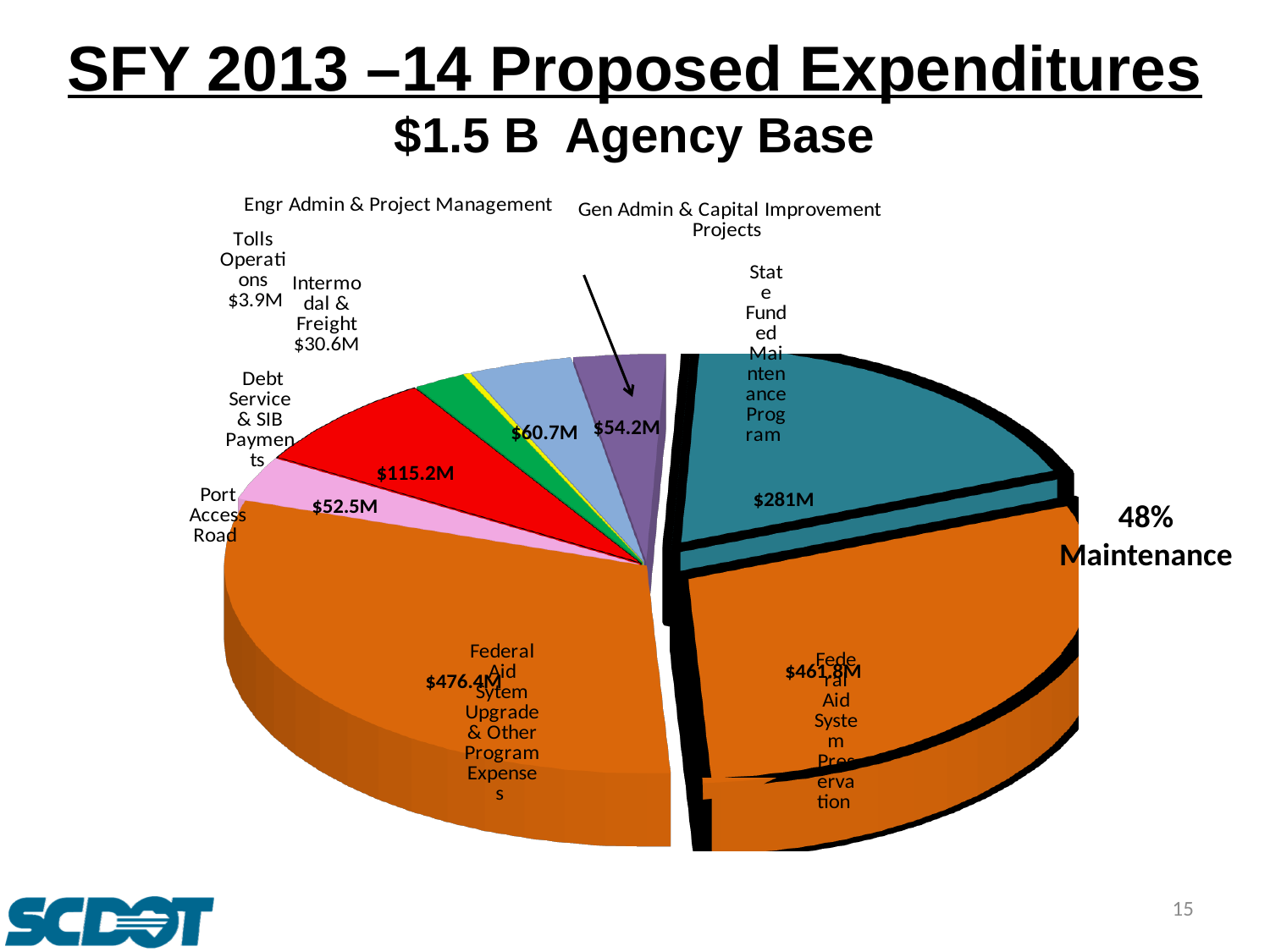
What is the value of the Gen Admin & Capital Improvement Projects slice? $54.2M How many slices does the pie chart have? 9 Which category has the largest value in the pie chart? Federal Aid System Upgrade & Other Program Expenses What type of chart is shown on the slide? Pie chart What is the value of the Tolls Operations slice? $3.9M What is the value of the State Funded Maintenance Program slice? $281M Which category has the smallest value in the pie chart? Tolls Operations What percentage is labelled as Maintenance next to the pie chart? 48% Which is larger, Debt Service & SIB Payments or Engr Admin & Project Management? Debt Service & SIB Payments What is the value of the Federal Aid System Preservation slice? $461.8M What is the difference between the Federal Aid System Upgrade & Other Program Expenses slice and the Federal Aid System Preservation slice? $14.6M What is the value of the Debt Service & SIB Payments slice? $115.2M